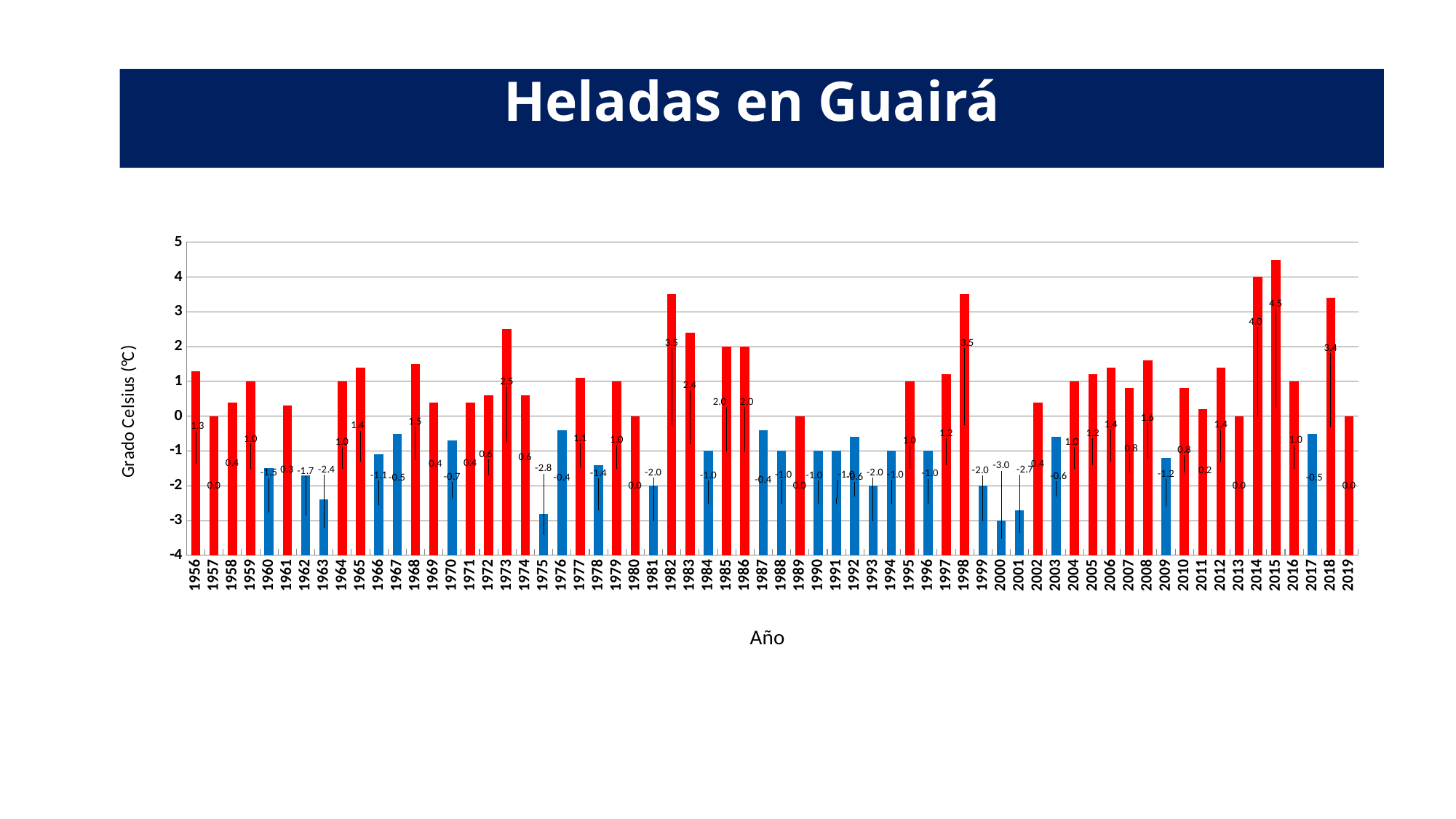
Is the value for 2014 greater or less than 3? greater Which year has the lowest value? 2000 What is the value for 1975? -2.8 How many years are shown on the x axis? 64 What is the value for 2000? -3.0 Which is larger, the value for 1982 or the value for 1983? 1982 What is the difference between the values for 2015 and 2014? 0.5 Which year has the highest value? 2015 What is the value for 1982? 3.5 What kind of chart is shown? bar chart What is the value for 2015? 4.5 What is the label of the y axis? Grado Celsius (°C)